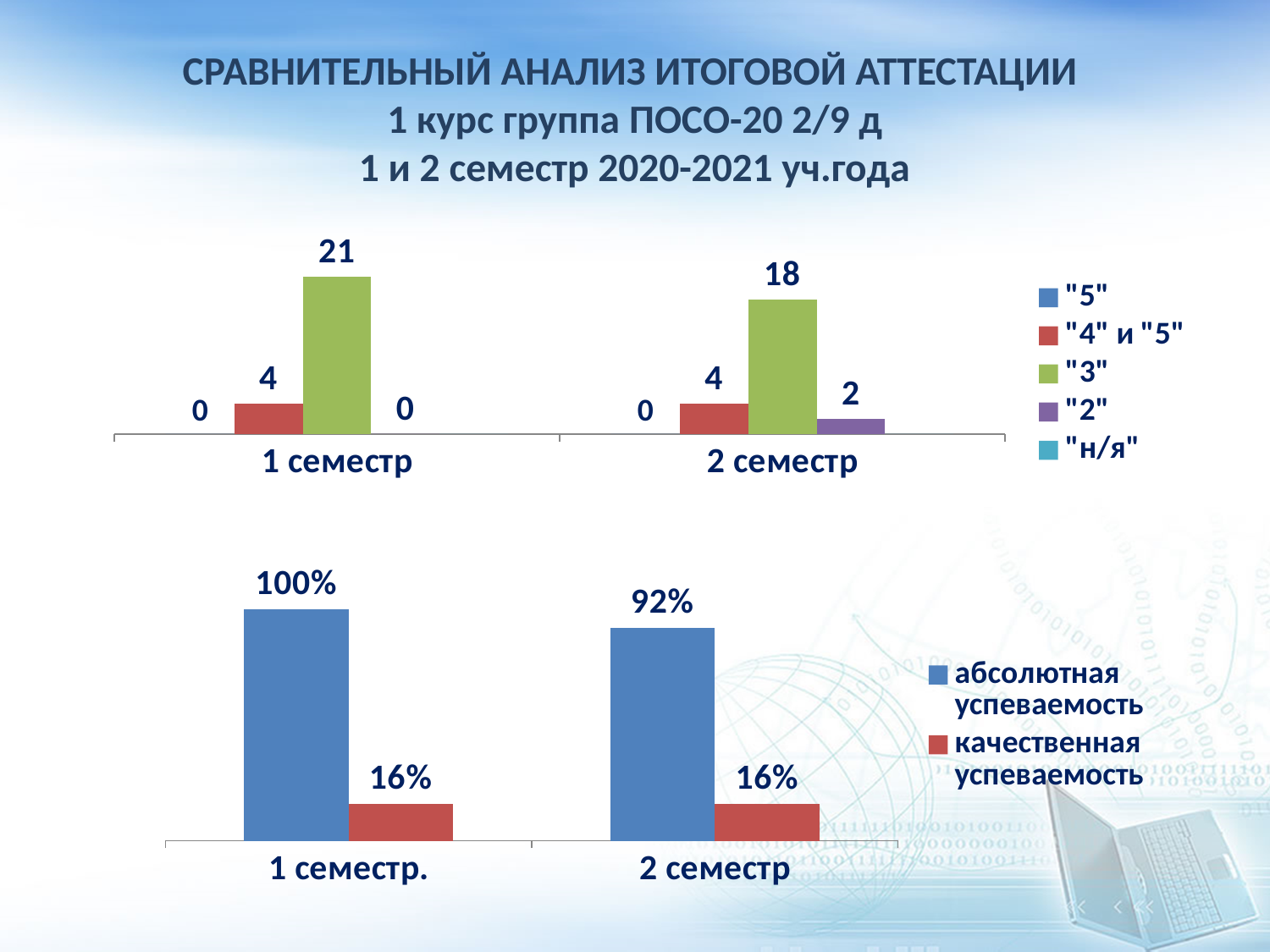
In the bottom chart, what is the value for абсолютная успеваемость in 2 семестр? 92% In the top chart, what is the value for "3" in 2 семестр? 18 In the top chart, what is the value for "3" in 1 семестр? 21 In the bottom chart, what is the difference between абсолютная успеваемость and качественная успеваемость in 2 семестр? 76% In the top chart, what is the value for "2" in 2 семестр? 2 In the top chart, what is the value for "4" и "5" in 1 семестр? 4 In the bottom chart, what is the value for качественная успеваемость in 2 семестр? 16% In the top chart, how many series does the legend list? 5 In the top chart, which series has the highest value in 2 семестр? "3" In the bottom chart, what is the value for абсолютная успеваемость in 1 семестр.? 100% In the top chart, what is the difference between the "3" values for 1 семестр and 2 семестр? 3 What kind of chart is the bottom chart? bar chart